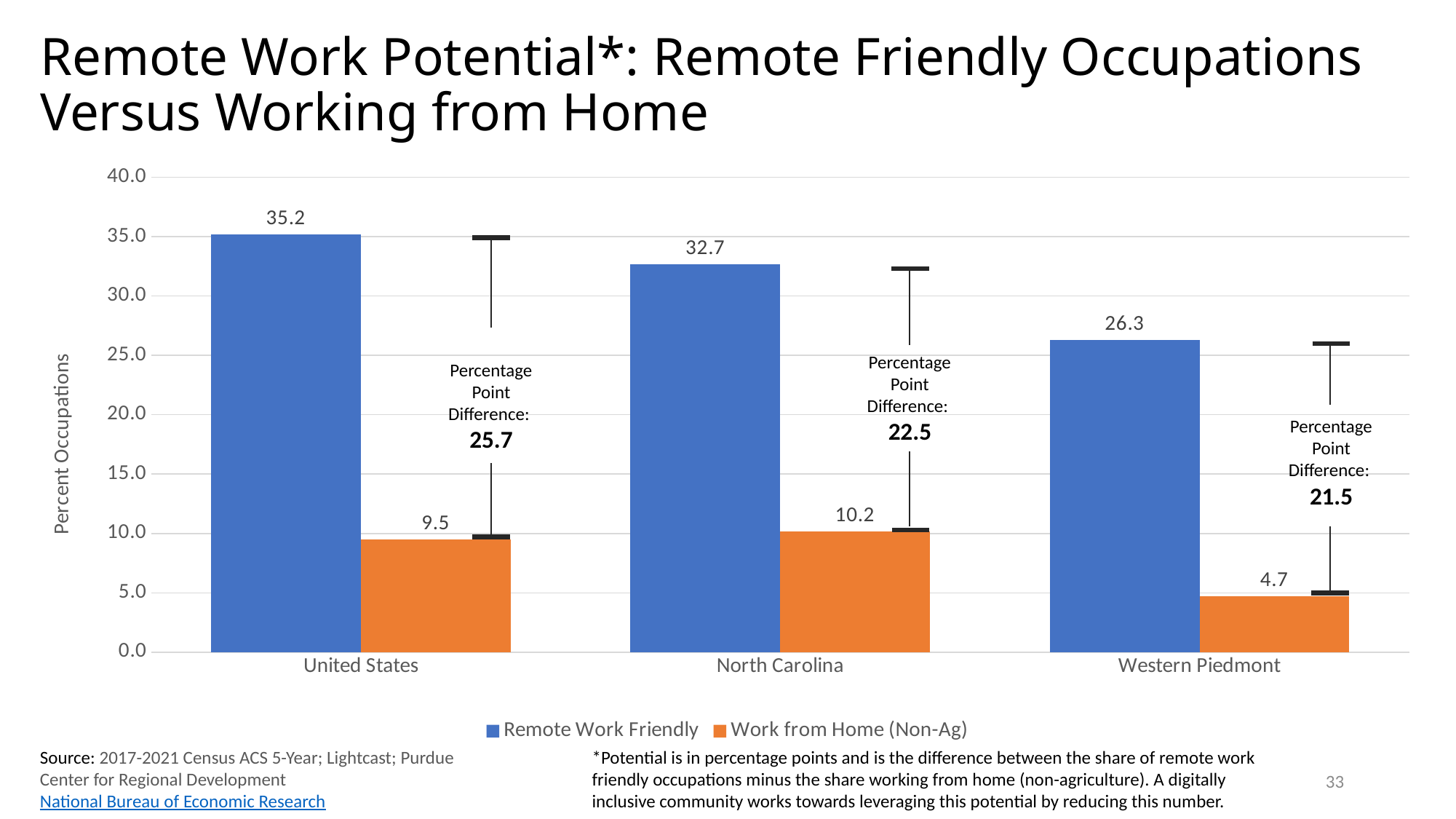
What is the Work from Home (Non-Ag) value for North Carolina? 10.2 What is the Remote Work Friendly value for the United States? 35.2 What is the difference between the Remote Work Friendly and Work from Home (Non-Ag) values for North Carolina? 22.5 Which is larger: the Remote Work Friendly value for North Carolina or for Western Piedmont? North Carolina What is the Work from Home (Non-Ag) value for Western Piedmont? 4.7 How many series does the legend list? 2 How many regions are shown on the x axis? 3 What kind of chart is shown on the slide? Bar chart Which region has the highest Remote Work Friendly value? United States Is the Remote Work Friendly value for Western Piedmont greater or less than 25.0? greater Which region has the lowest Work from Home (Non-Ag) value? Western Piedmont What is the label of the y axis? Percent Occupations